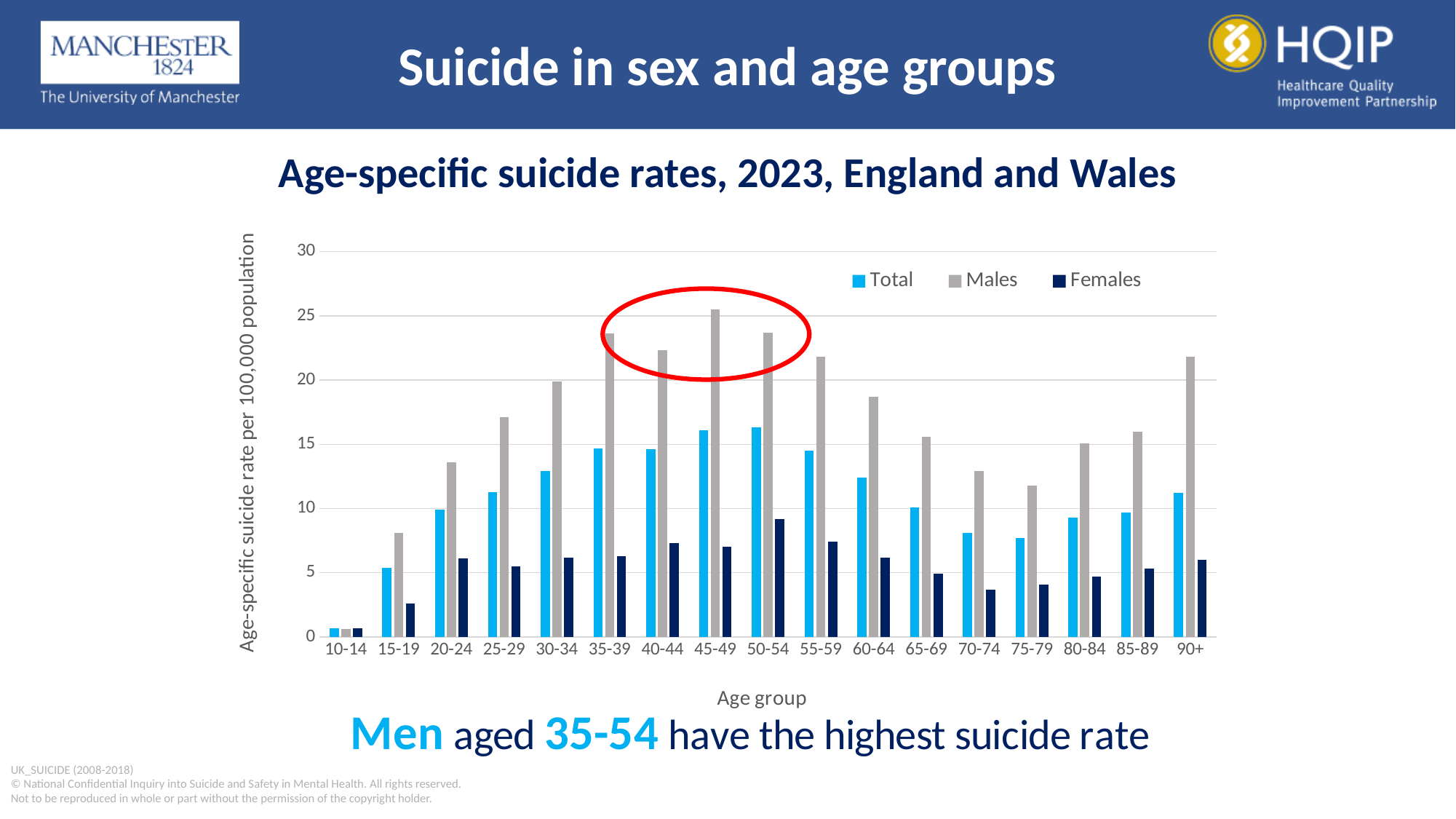
How many age groups are shown on the x axis? 17 What is the label on the y axis? Age-specific suicide rate per 100,000 population Do the Males values rise or fall from the 10-14 age group to the 45-49 age group? Rise How many series does the legend list? 3 Is the value for Total in the 75-79 age group greater or less than 10? less Which age group has the highest value for Males? 45-49 Is the value for Males in the 90+ age group greater or less than 20? greater Which is larger: the Males value for 90+ or the Males value for 85-89? 90+ Which age group has the highest value for Females? 50-54 Is the value for Females in the 70-74 age group greater or less than 5? less Which age group has the lowest value for Males? 10-14 What kind of chart is shown on the slide? Bar chart